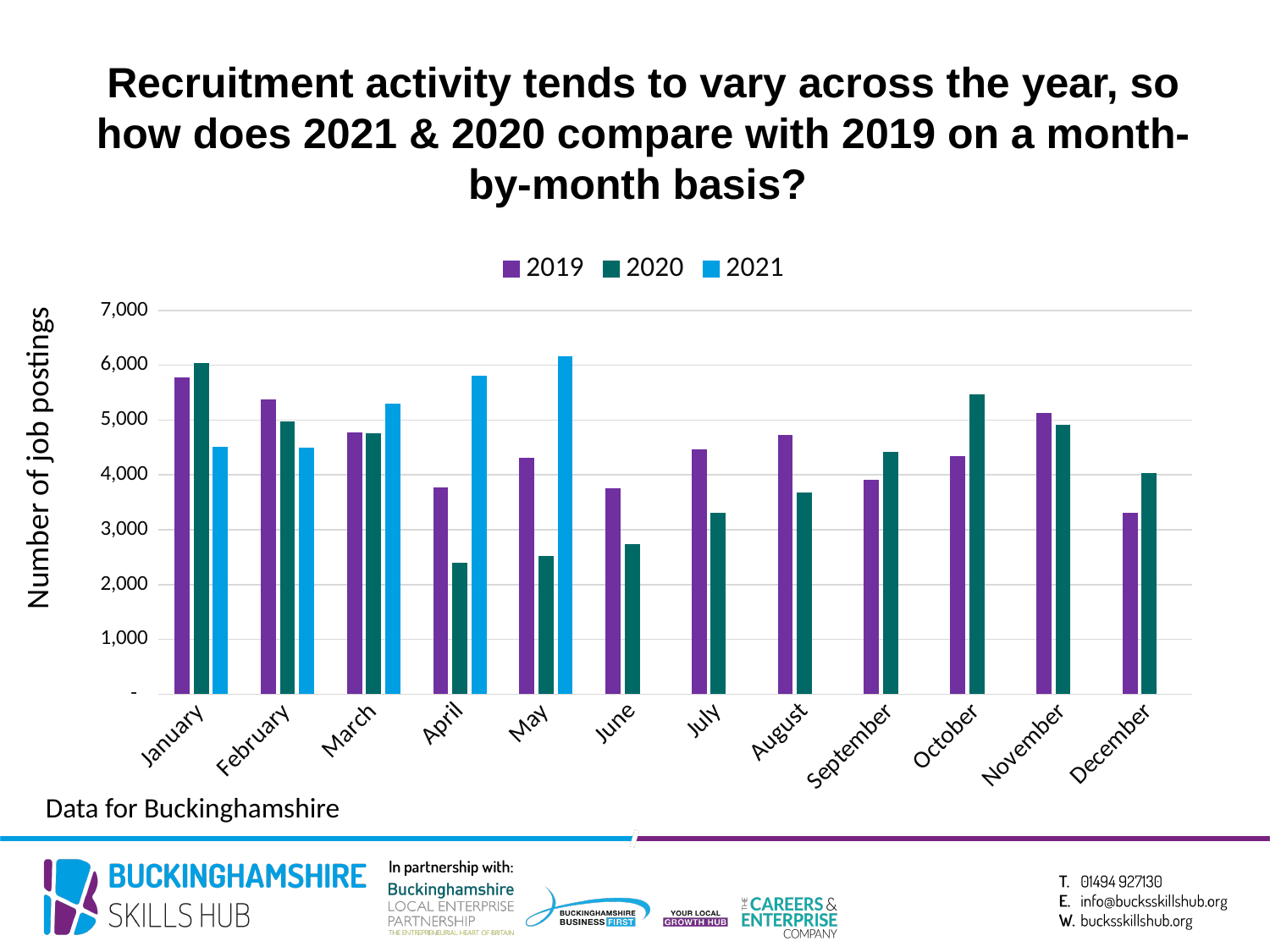
How many series does the legend list? 3 Is the 2021 value for May greater or less than 6,000? greater For how many months is a 2021 bar plotted? 5 Is the 2020 value for April greater or less than 3,000? less In October, which is larger: the 2019 value or the 2020 value? 2020 What is the title of the vertical axis? Number of job postings What kind of chart is shown on the slide? Bar chart In which month is the 2021 value highest? May In January, which is larger: the 2019 value or the 2020 value? 2020 In which month is the 2019 value highest? January In which month is the 2020 value lowest? April How many months are shown along the x axis? 12